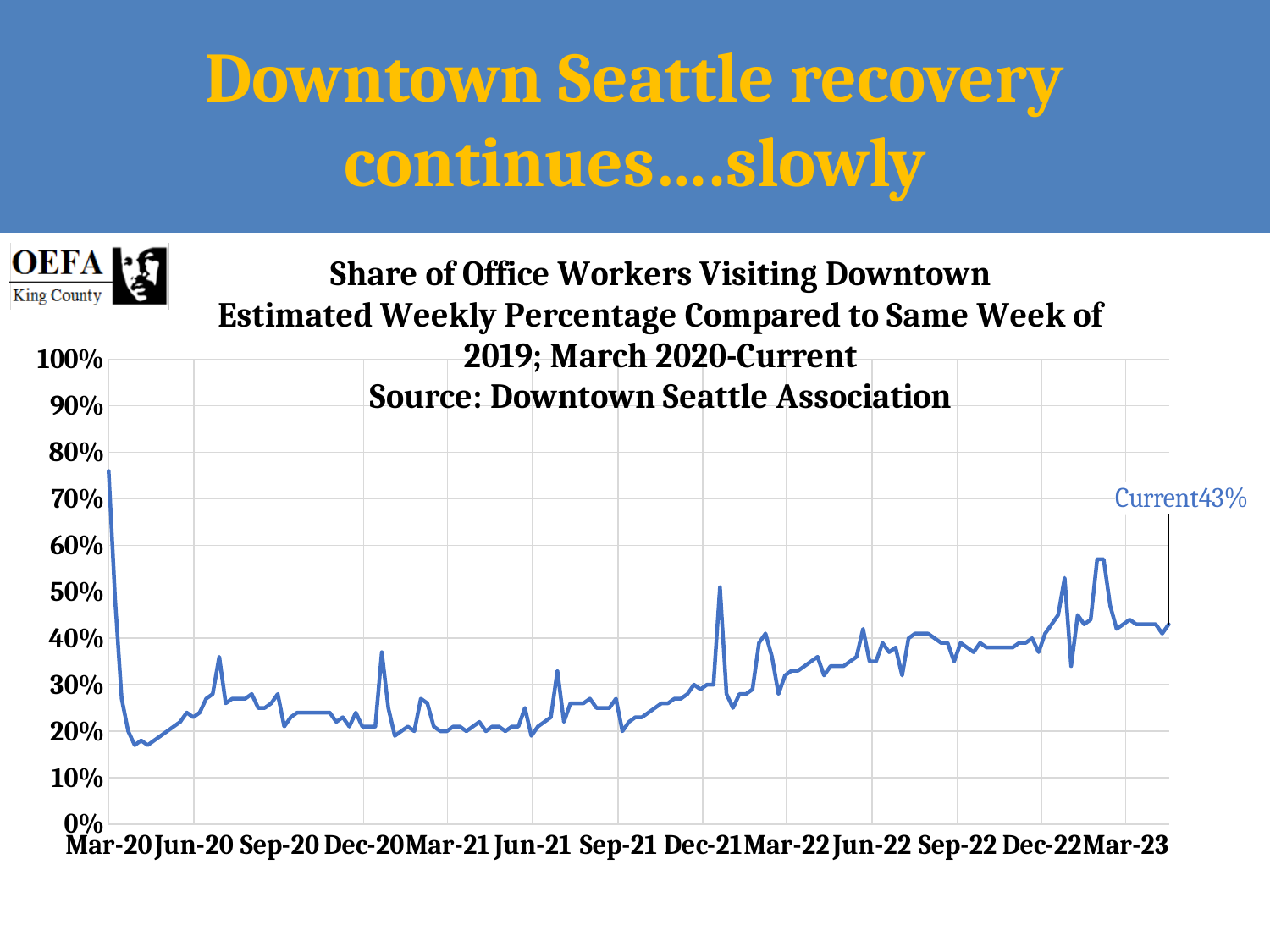
What is the current share of office workers visiting downtown, as labeled on the chart? 43% Is the value at Mar-20, the first point on the chart, greater or less than 70%? greater Is the lowest point on the line greater or less than 20%? less What kind of chart is shown on the slide? line chart At which x-axis label does the line reach its highest value? Mar-20 What is the highest value shown on the y axis? 100% What is the source of the data cited in the chart title? Downtown Seattle Association Overall, do the values rise or fall from Mar-21 to Mar-23? rise Is the value around Sep-22 greater or less than 30%? greater How many date labels are shown on the x axis? 13 Which is larger: the value at Mar-20 or the current value of 43%? Mar-20